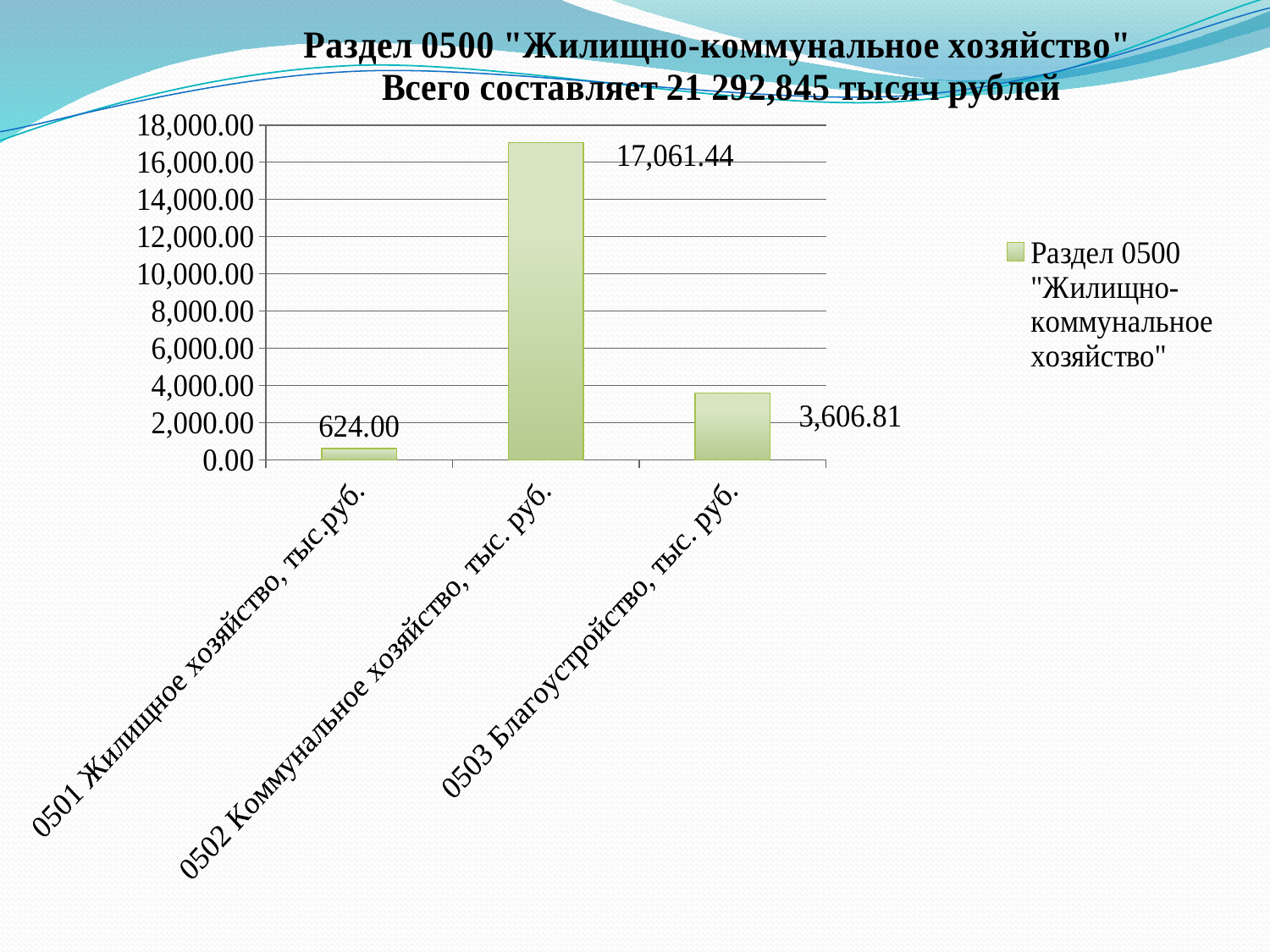
Which category has the highest value? 0502 Коммунальное хозяйство Which is larger, the value for 0503 Благоустройство or the value for 0501 Жилищное хозяйство? 0503 Благоустройство What is the difference between the values for 0502 Коммунальное хозяйство and 0503 Благоустройство? 13,454.63 What is the value for 0502 Коммунальное хозяйство? 17,061.44 Which category has the lowest value? 0501 Жилищное хозяйство What is the value for 0503 Благоустройство? 3,606.81 What is the value for 0501 Жилищное хозяйство? 624.00 What series name does the legend show? Раздел 0500 "Жилищно-коммунальное хозяйство" How many categories are shown on the x axis? 3 What kind of chart is shown on the slide? bar chart Is the value for 0502 Коммунальное хозяйство greater or less than 16,000.00? greater What is the difference between the values for 0503 Благоустройство and 0501 Жилищное хозяйство? 2,982.81